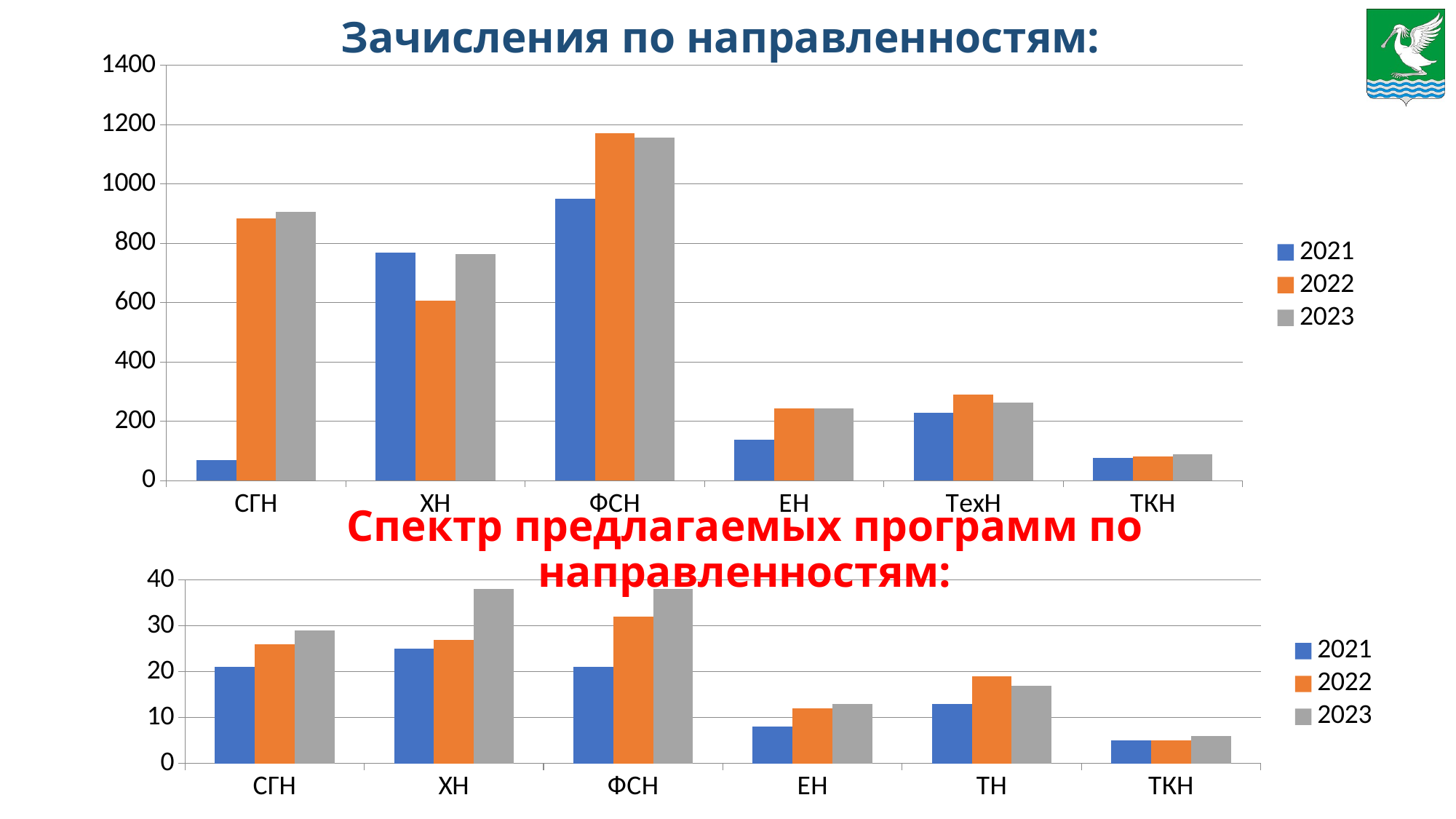
In the top chart "Зачисления по направленностям:", how many series does the legend list? 3 What kind of chart is the top chart titled "Зачисления по направленностям:"? bar chart In the top chart "Зачисления по направленностям:", which category has the highest value for 2022? ФСН In the bottom chart "Спектр предлагаемых программ по направленностям:", do the values for СГН rise or fall from 2021 to 2023? rise In the top chart "Зачисления по направленностям:", is the 2022 value for ХН greater or less than 800? less In the top chart "Зачисления по направленностям:", how many categories are shown on the x axis? 6 In the top chart "Зачисления по направленностям:", which is larger for СГН: the 2021 value or the 2022 value? 2022 In the top chart "Зачисления по направленностям:", which category has the lowest value for 2023? ТКН In the bottom chart "Спектр предлагаемых программ по направленностям:", which category has the highest value for 2022? ФСН In the top chart "Зачисления по направленностям:", is the 2021 value for ФСН greater or less than 800? greater In the bottom chart "Спектр предлагаемых программ по направленностям:", is the 2022 value for ФСН greater or less than 30? greater In the bottom chart "Спектр предлагаемых программ по направленностям:", which category has the lowest value for 2021? ТКН